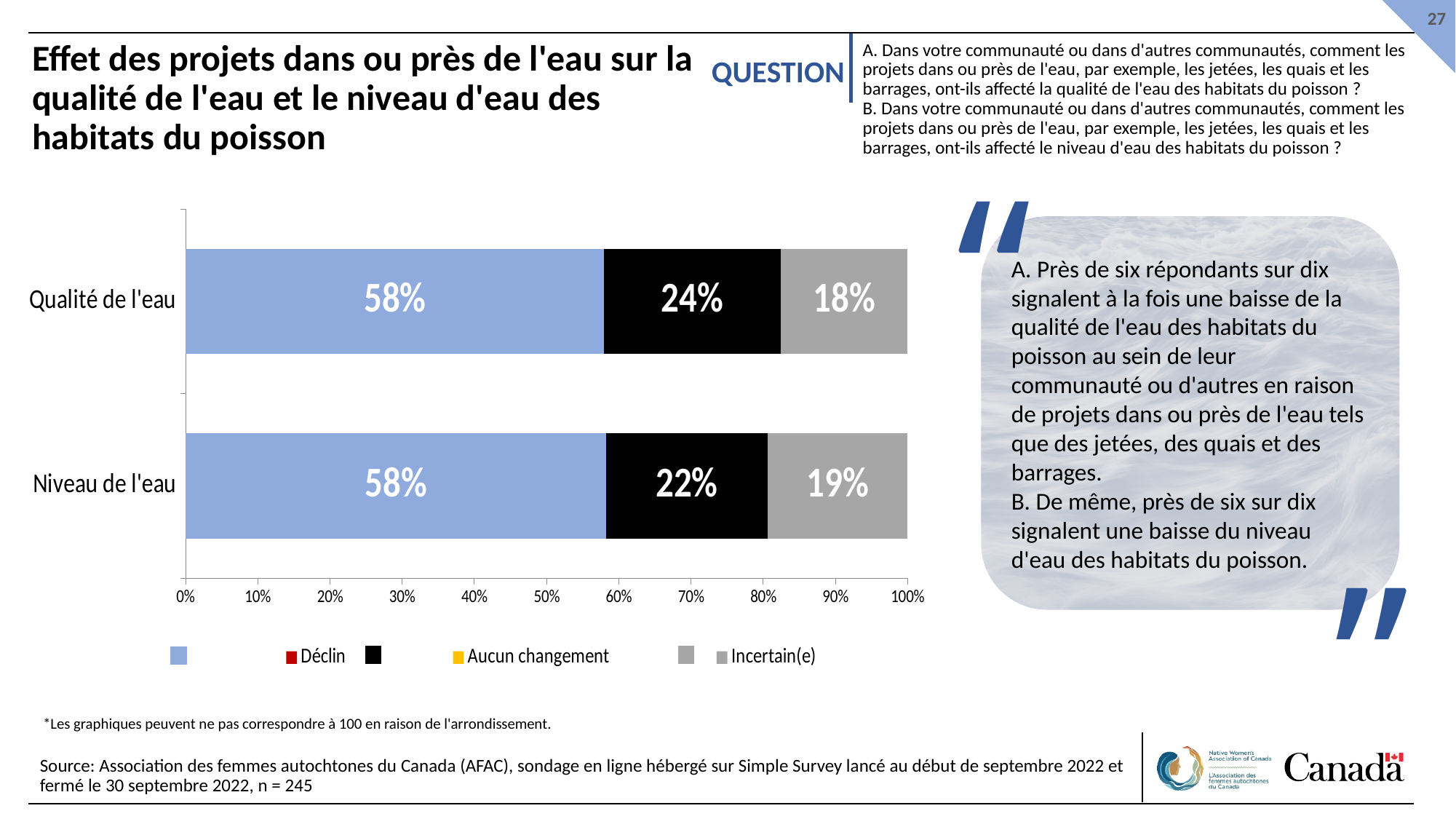
Which segment is the largest in the Niveau de l'eau bar? Déclin (58%) What percentage of respondents were uncertain (Incertain(e)) about the effect on water quality (Qualité de l'eau)? 18% Which segment is the smallest in the Qualité de l'eau bar? Incertain(e) (18%) What percentage of respondents reported no change (Aucun changement) in water level (Niveau de l'eau)? 22% Which category has the larger 'Incertain(e)' share, Qualité de l'eau or Niveau de l'eau? Niveau de l'eau How many categories are shown on the chart? 2 What percentage of respondents were uncertain (Incertain(e)) about the effect on water level (Niveau de l'eau)? 19% What kind of chart is shown on the slide? Stacked horizontal bar chart What percentage of respondents reported a decline (Déclin) in water quality (Qualité de l'eau)? 58% What is the total of the segments in the Qualité de l'eau bar? 100% What is the difference between the 'Aucun changement' share for Qualité de l'eau and for Niveau de l'eau? 2% How many series does the legend list? 3